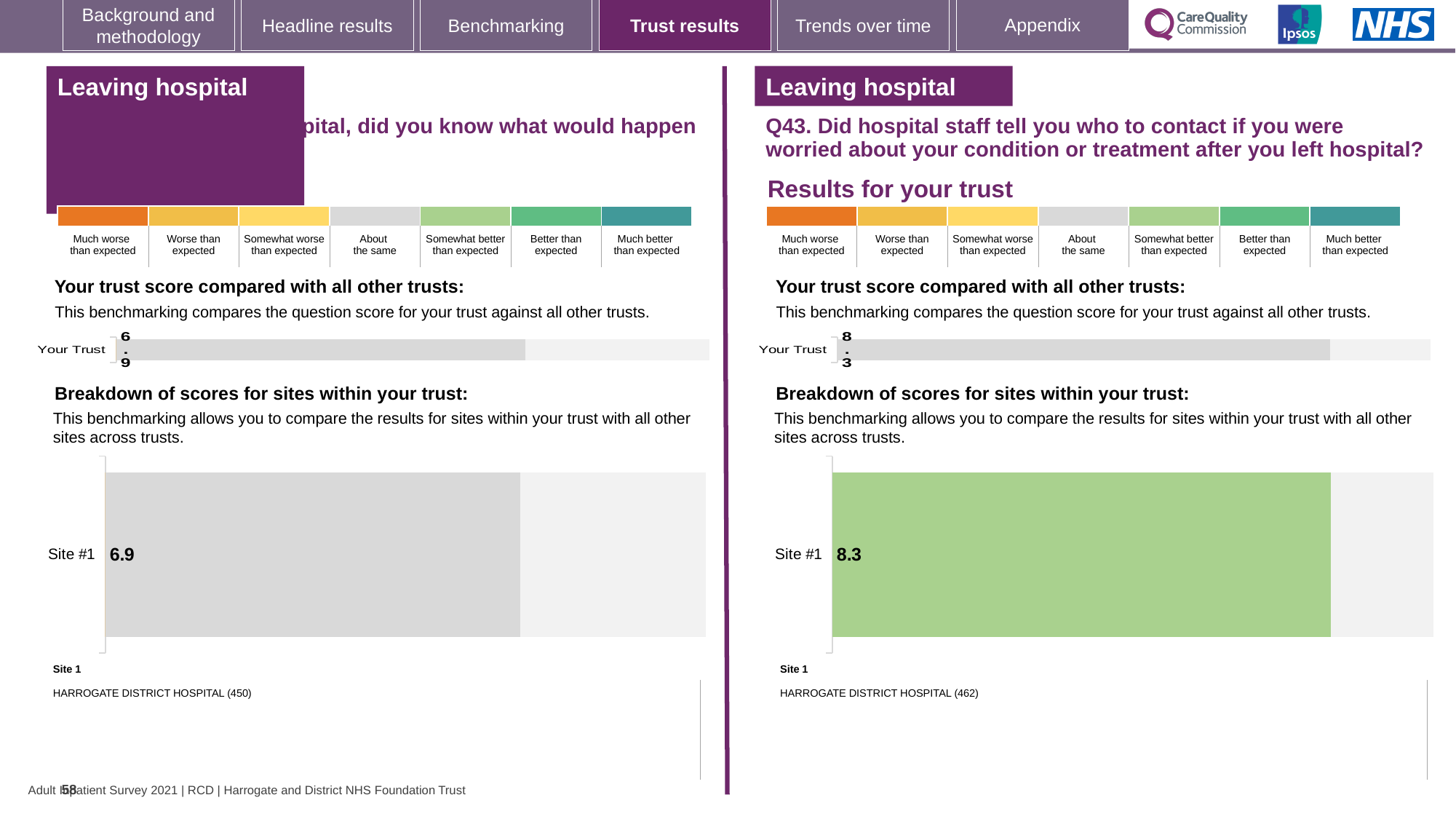
Is the Q43 Site #1 score greater or less than the left-hand Your Trust score of 6.9? greater On the right-hand side (Q43), what is the score shown for Your Trust? 8.3 Which site is listed as Site 1 on the left-hand side of the slide? HARROGATE DISTRICT HOSPITAL (450) On the left-hand side of the slide, what is the score shown for Your Trust? 6.9 In the left-hand breakdown of scores for sites within your trust, what is the score for Site #1? 6.9 Which site is listed as Site 1 on the right-hand (Q43) side of the slide? HARROGATE DISTRICT HOSPITAL (462) How many sites are shown in the Q43 breakdown of scores for sites within your trust? 1 What type of chart is used to show the breakdown of scores for sites within your trust? Bar chart Which is larger: the Site #1 score on the left-hand chart or the Site #1 score on the right-hand (Q43) chart? Right-hand (Q43) chart What is the difference between the Q43 Site #1 score and the left-hand Site #1 score? 1.4 In the Q43 breakdown of scores for sites within your trust, what is the score for Site #1? 8.3